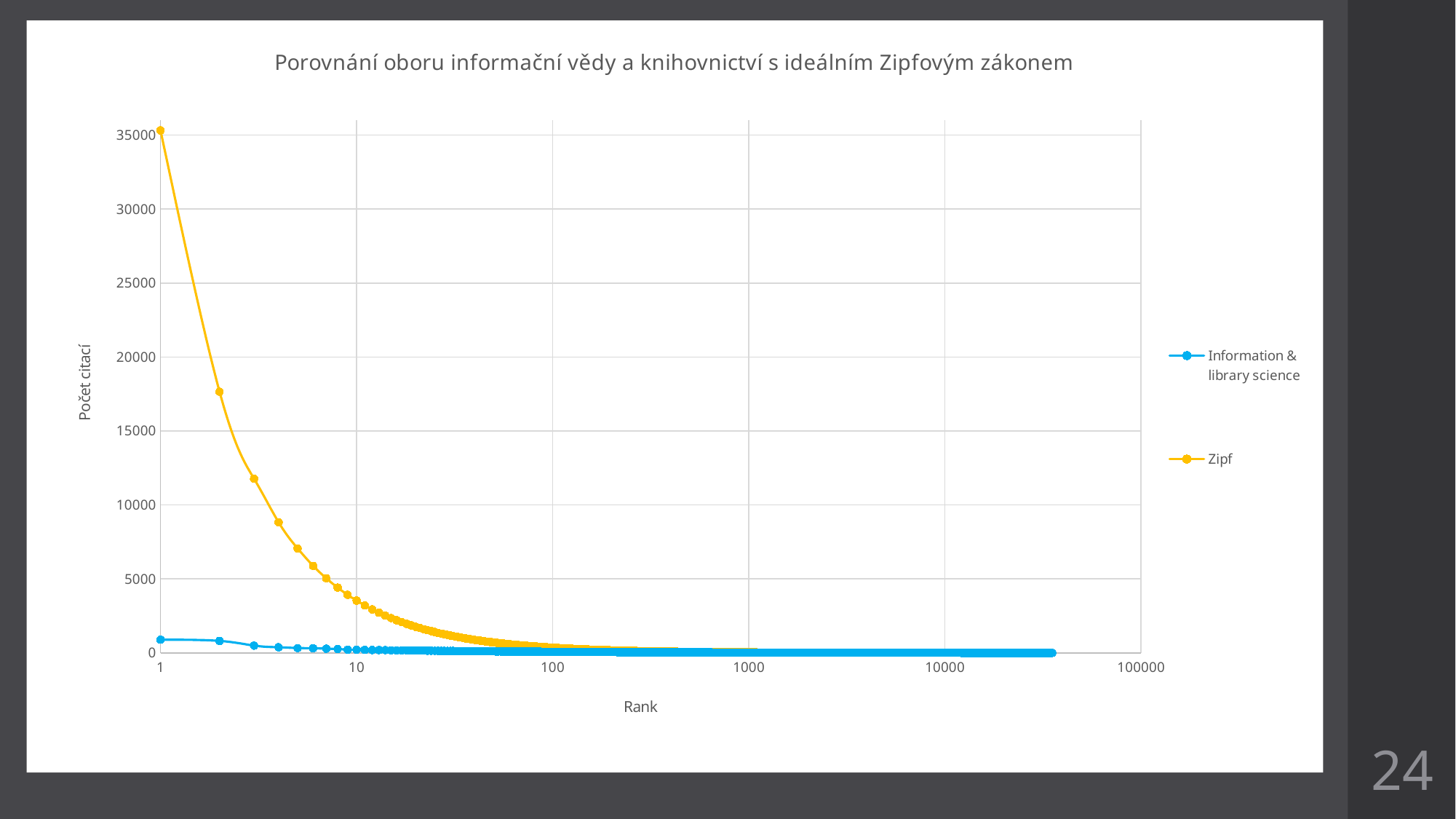
At Rank 1, which series has the higher value, Zipf or Information & library science? Zipf What is the label of the y axis? Počet citací Is the value of the Zipf series at Rank 10 greater or less than 5000? less Is the value of the Zipf series at Rank 3 greater or less than 10000? greater Is the value of the Zipf series at Rank 2 greater or less than 15000? greater How many series does the legend list? 2 Do the values of the Zipf series rise or fall as Rank increases? fall What is the title of the chart? Porovnání oboru informační vědy a knihovnictví s ideálním Zipfovým zákonem Which series reaches the highest value on the chart? Zipf What kind of chart is shown on the slide? line chart